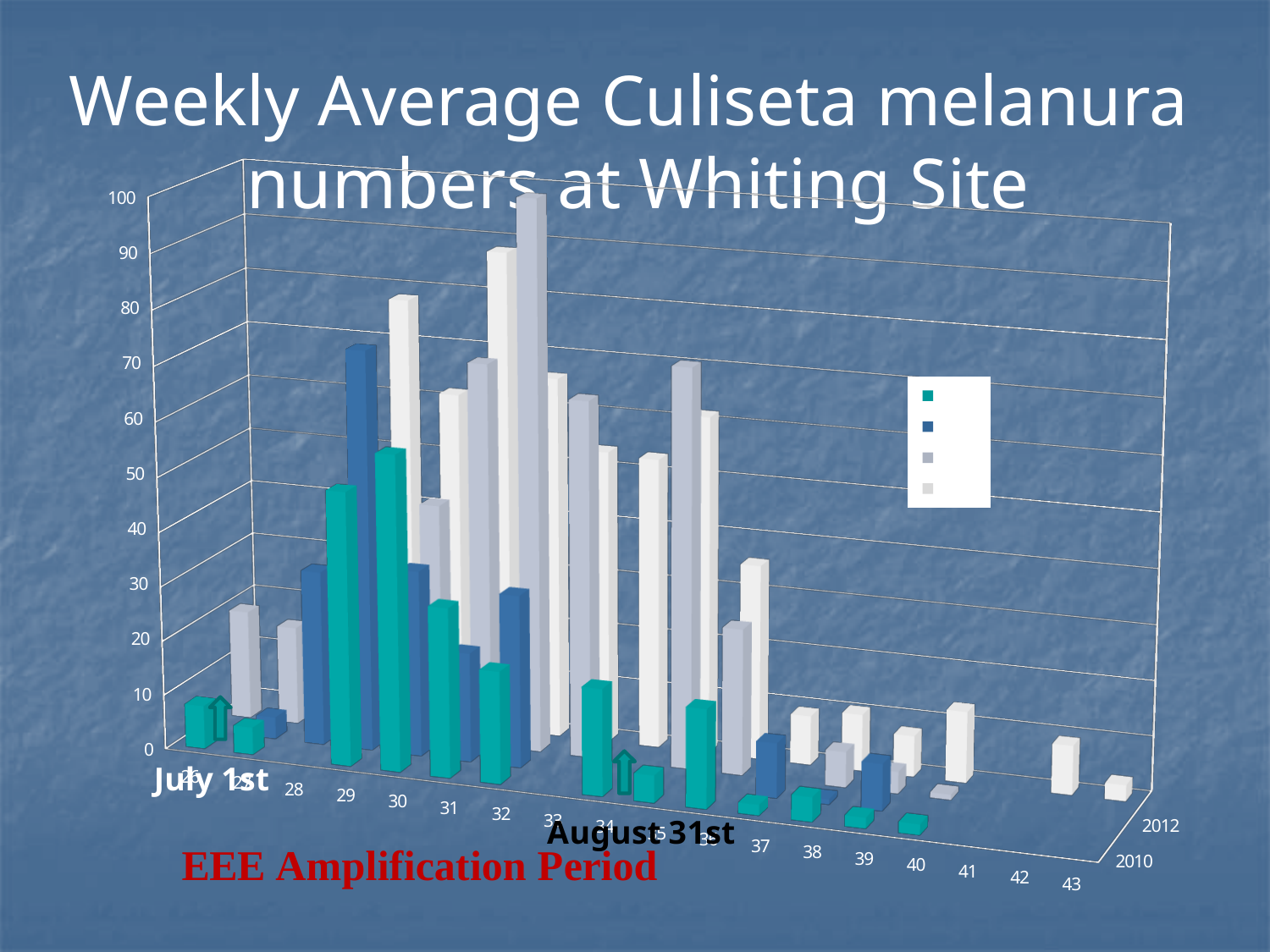
What is the highest value shown on the vertical axis? 100 Which is larger, the teal bar for week 30 or the teal bar for week 34? week 30 Is the value of the teal bar for week 39 greater or less than 10? less How many week categories are labelled along the x axis? 18 Is the value of the teal bar for week 30 greater or less than 40? greater Is the value of the teal bar for week 29 greater or less than 30? greater What kind of chart is shown on the slide? bar chart How many series does the legend list? 4 What is the title of the chart? Weekly Average Culiseta melanura numbers at Whiting Site What is the last week number labelled on the x axis? 43